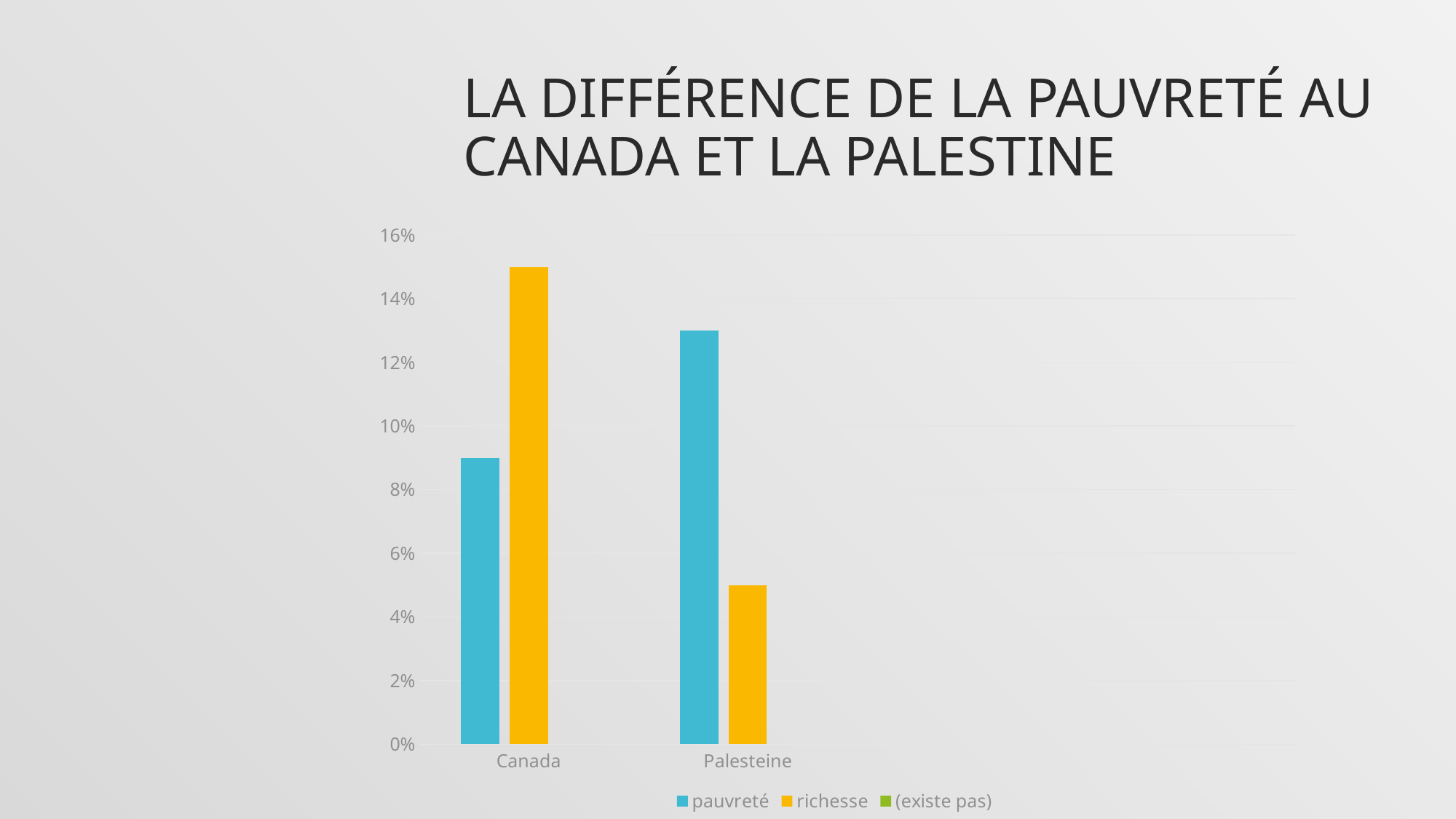
Is the pauvreté value for Palesteine greater or less than 12%? greater Which bar is the tallest in the chart? richesse for Canada How many categories are shown on the x axis of the chart? 2 How many series does the chart legend list? 3 What colour represents the richesse series in the chart? yellow Which bar is the shortest in the chart? richesse for Palesteine Is the richesse value for Canada greater or less than 14%? greater Which category has the higher richesse value, Canada or Palesteine? Canada Is the richesse value for Palesteine greater or less than 6%? less What kind of chart is shown on the slide? bar chart Which category has the higher pauvreté value, Canada or Palesteine? Palesteine